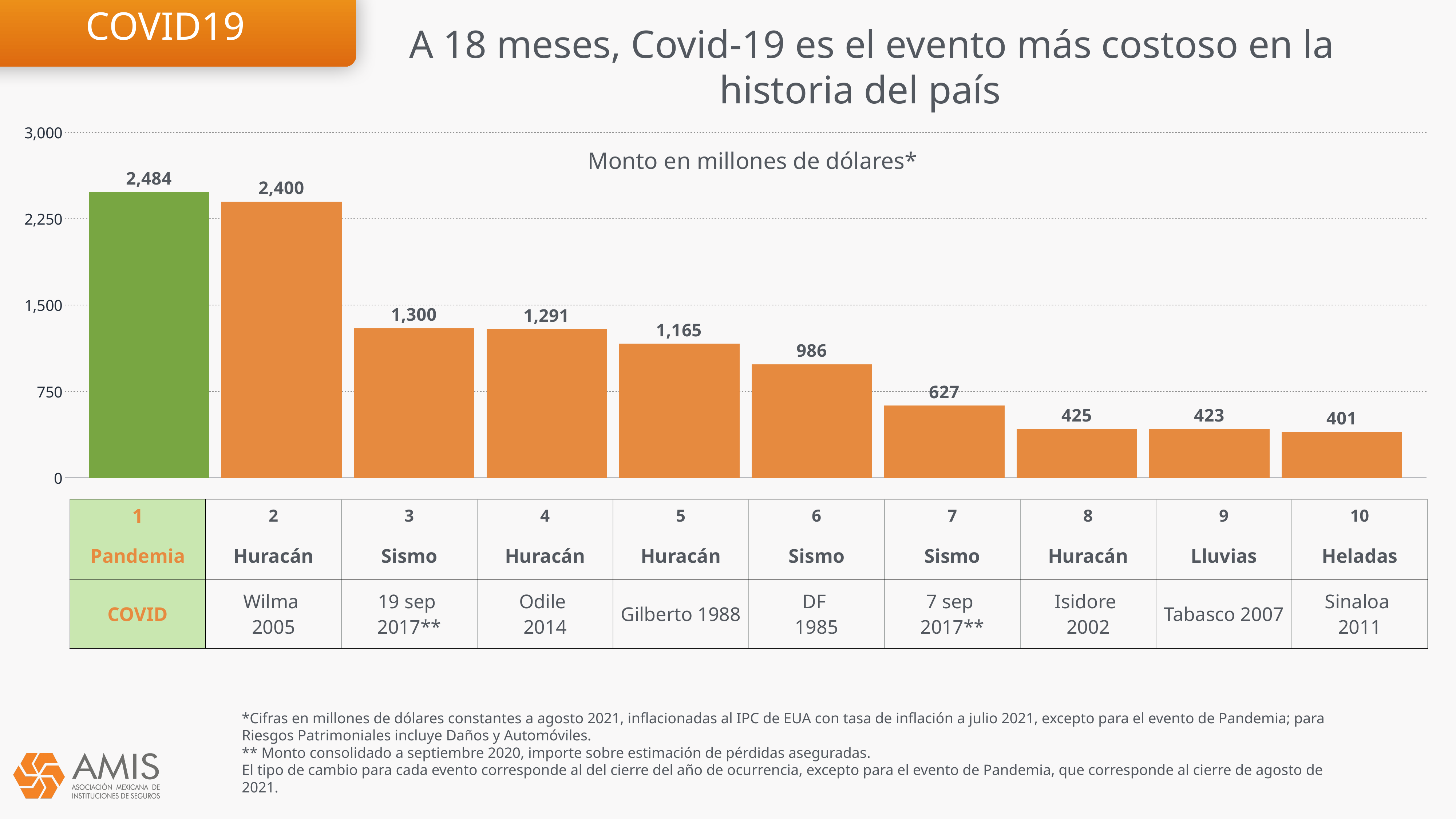
What is the value for the Pandemia COVID bar (rank 1)? 2,484 Do the values rise or fall from left to right across the bars? Fall What unit does the chart subtitle say the amounts are in? Millones de dólares How many bars (events) are shown in the chart? 10 What is the value for Huracán Gilberto 1988 (rank 5)? 1,165 What kind of chart is shown on the slide? Bar chart What is the value for Heladas Sinaloa 2011 (rank 10)? 401 Which event has the lowest value in the chart? Heladas Sinaloa 2011 What is the value for Huracán Wilma 2005 (rank 2)? 2,400 What is the difference between the Pandemia COVID value and the Huracán Wilma 2005 value? 84 Which is larger: the value for Sismo 19 sep 2017 (rank 3) or Huracán Odile 2014 (rank 4)? Sismo 19 sep 2017 Which event has the highest value in the chart? Pandemia COVID